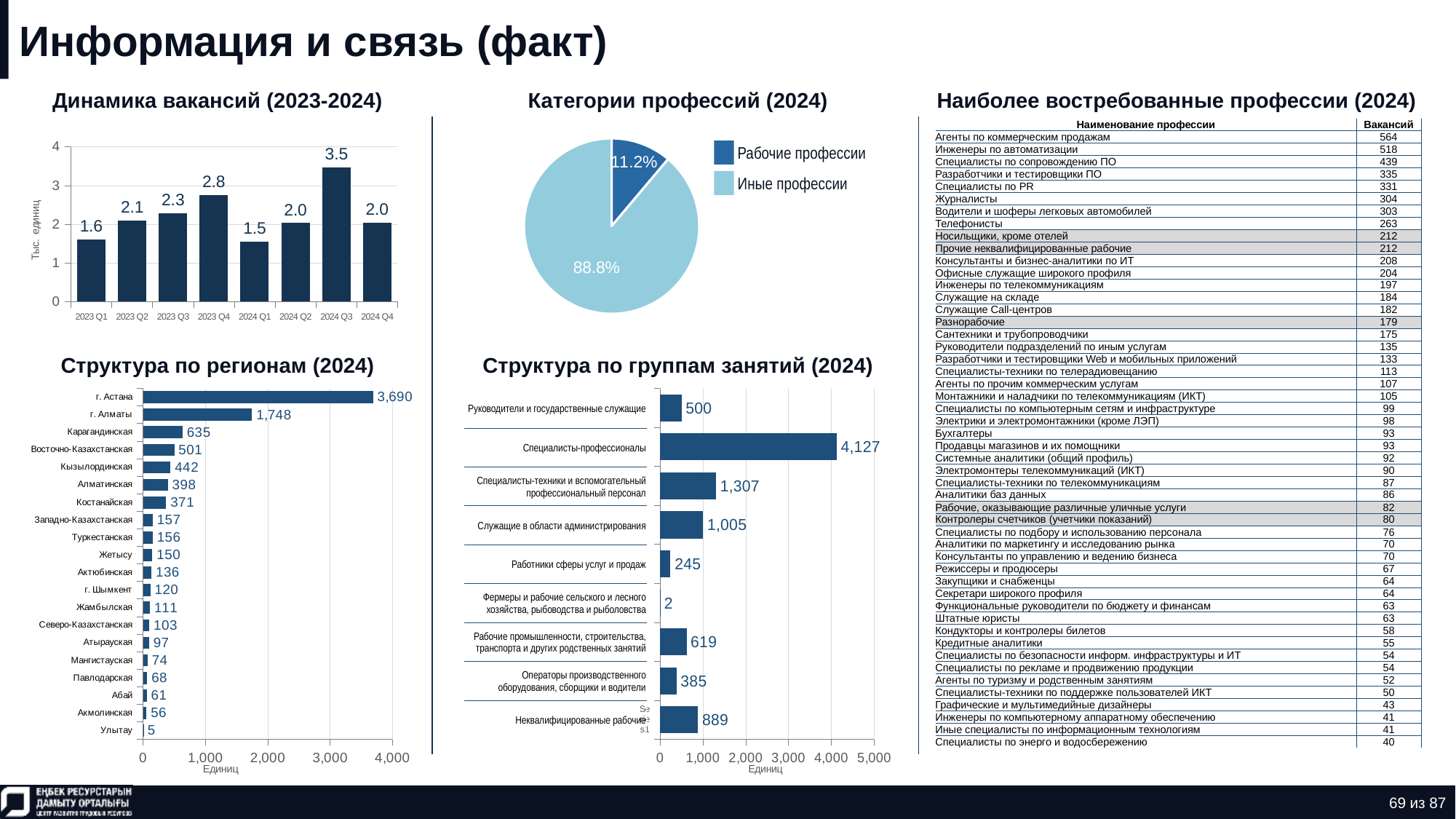
In the chart 'Динамика вакансий (2023-2024)', what is the value for 2024 Q3? 3.5 In the chart 'Структура по регионам (2024)', which region has the highest value? г. Астана What kind of chart is 'Категории профессий (2024)'? pie chart What kind of chart is 'Структура по группам занятий (2024)'? bar chart In the chart 'Динамика вакансий (2023-2024)', what is the difference between 2023 Q4 and 2023 Q1? 1.2 In the chart 'Динамика вакансий (2023-2024)', which quarter has the lowest value? 2024 Q1 In the chart 'Структура по группам занятий (2024)', what is the value for 'Специалисты-профессионалы'? 4,127 In the chart 'Категории профессий (2024)', what share of the pie is 'Рабочие профессии'? 11.2% In the chart 'Структура по регионам (2024)', what is the value for г. Алматы? 1,748 In the chart 'Структура по группам занятий (2024)', which group has the lowest value? Фермеры и рабочие сельского и лесного хозяйства, рыбоводства и рыболовства In the chart 'Динамика вакансий (2023-2024)', how many quarters are plotted? 8 In the chart 'Структура по регионам (2024)', which is larger, Карагандинская or Восточно-Казахстанская? Карагандинская